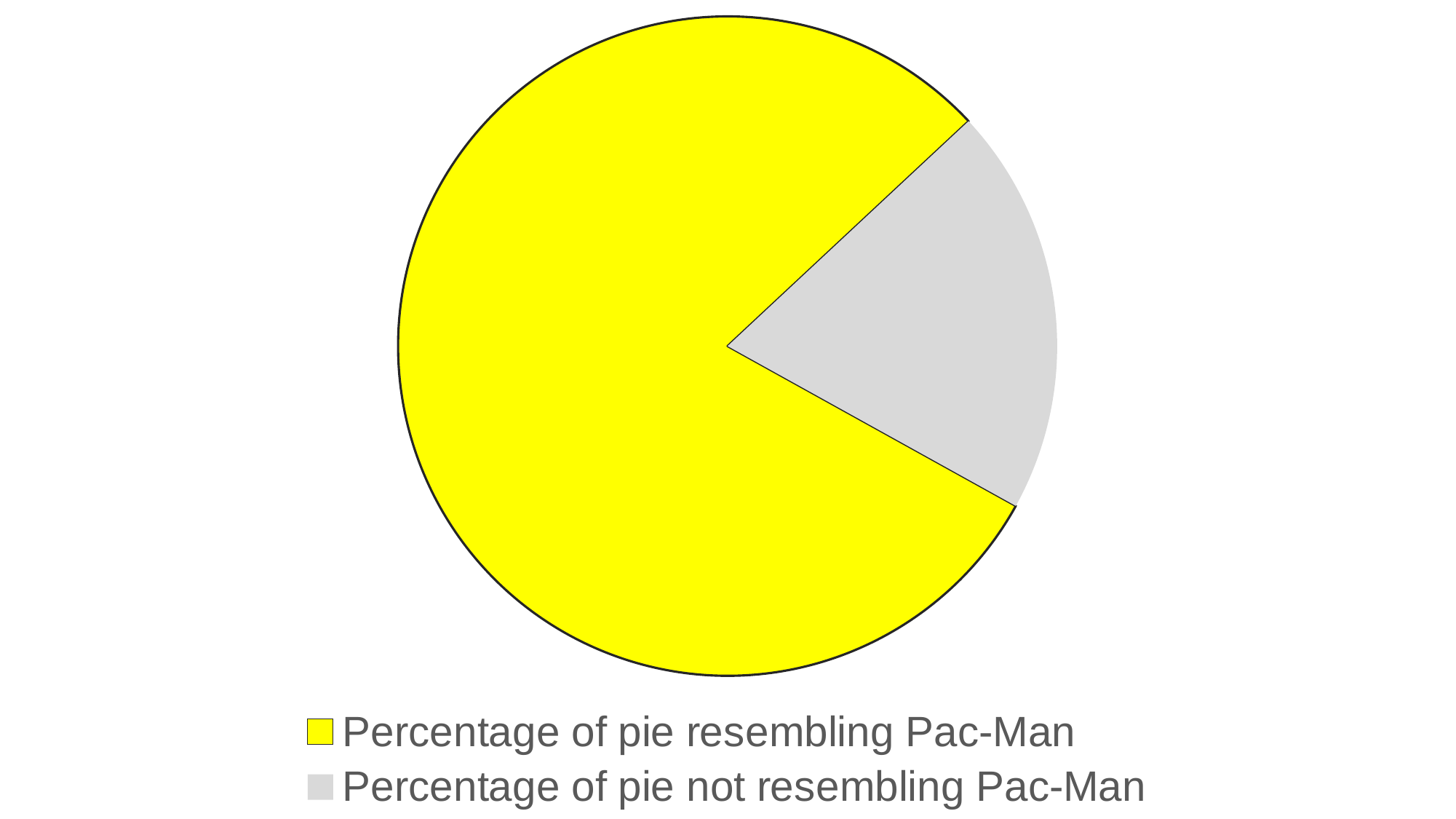
Which slice is the largest? Percentage of pie resembling Pac-Man What colour is the slice for "Percentage of pie not resembling Pac-Man"? grey How many slices does the pie chart have? 2 Which slice is the smallest? Percentage of pie not resembling Pac-Man What colour is the slice for "Percentage of pie resembling Pac-Man"? yellow Which is larger: the slice for "Percentage of pie resembling Pac-Man" or the slice for "Percentage of pie not resembling Pac-Man"? Percentage of pie resembling Pac-Man How many entries does the legend list? 2 What kind of chart is shown on the slide? pie chart